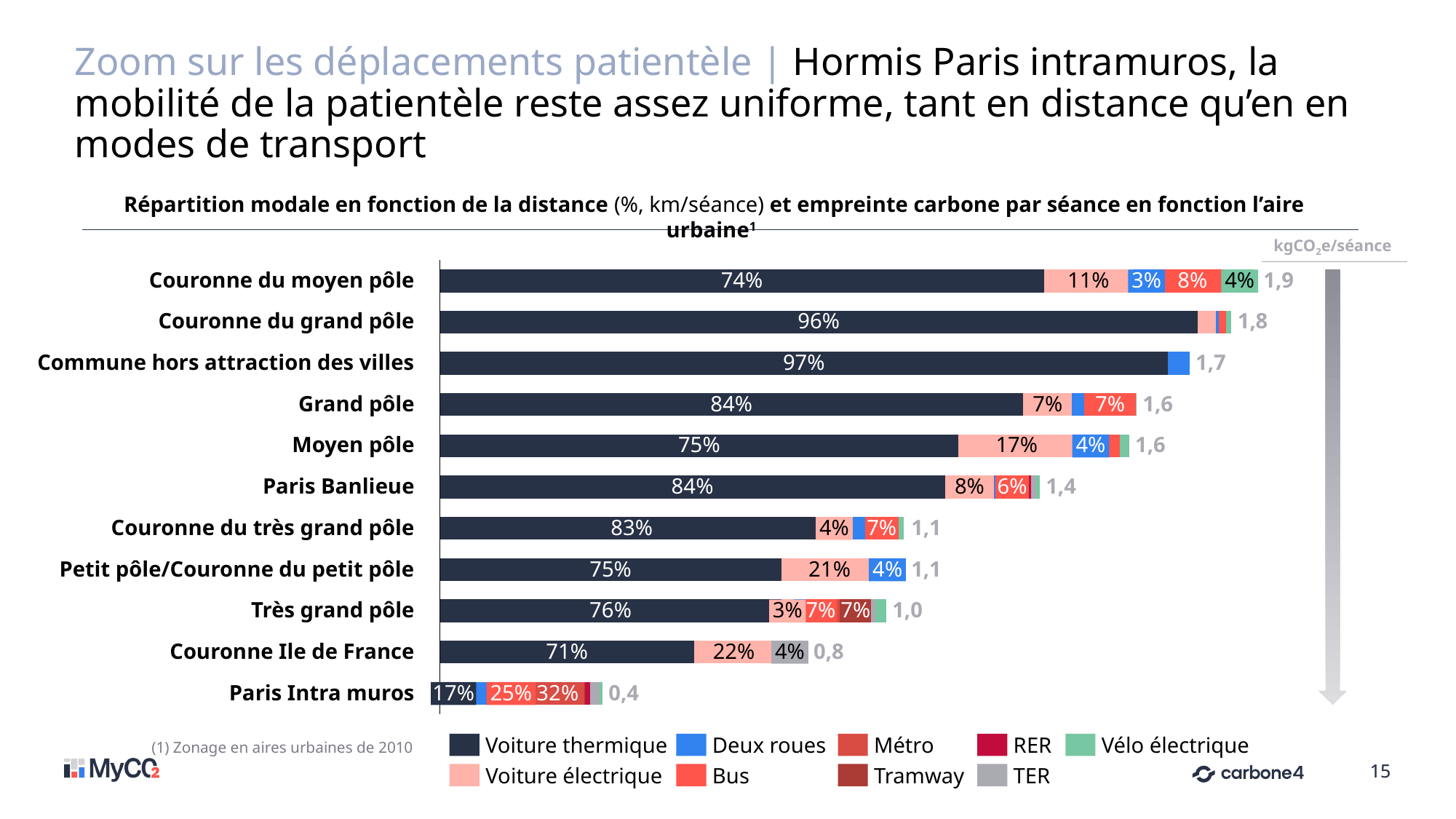
What is the difference in Voiture thermique share between Commune hors attraction des villes and Couronne Ile de France? 26% How many urban area categories are shown on the chart? 11 What share of Voiture électrique is shown for Couronne Ile de France? 22% Which urban area has the highest carbon footprint per session (kgCO₂e/séance)? Couronne du moyen pôle What unit is given for the grey values at the end of each bar? kgCO₂e/séance How many transport modes does the legend list? 9 Which urban area has the lowest share of Voiture thermique? Paris Intra muros What share of Métro is shown for Paris Intra muros? 32% What type of chart is used to show the modal split? Stacked bar chart Which has a larger Voiture électrique share, Moyen pôle or Petit pôle/Couronne du petit pôle? Petit pôle/Couronne du petit pôle What is the carbon footprint per session (kgCO₂e/séance) shown for Paris Intra muros? 0,4 What share of Voiture thermique is shown for Couronne du moyen pôle? 74%